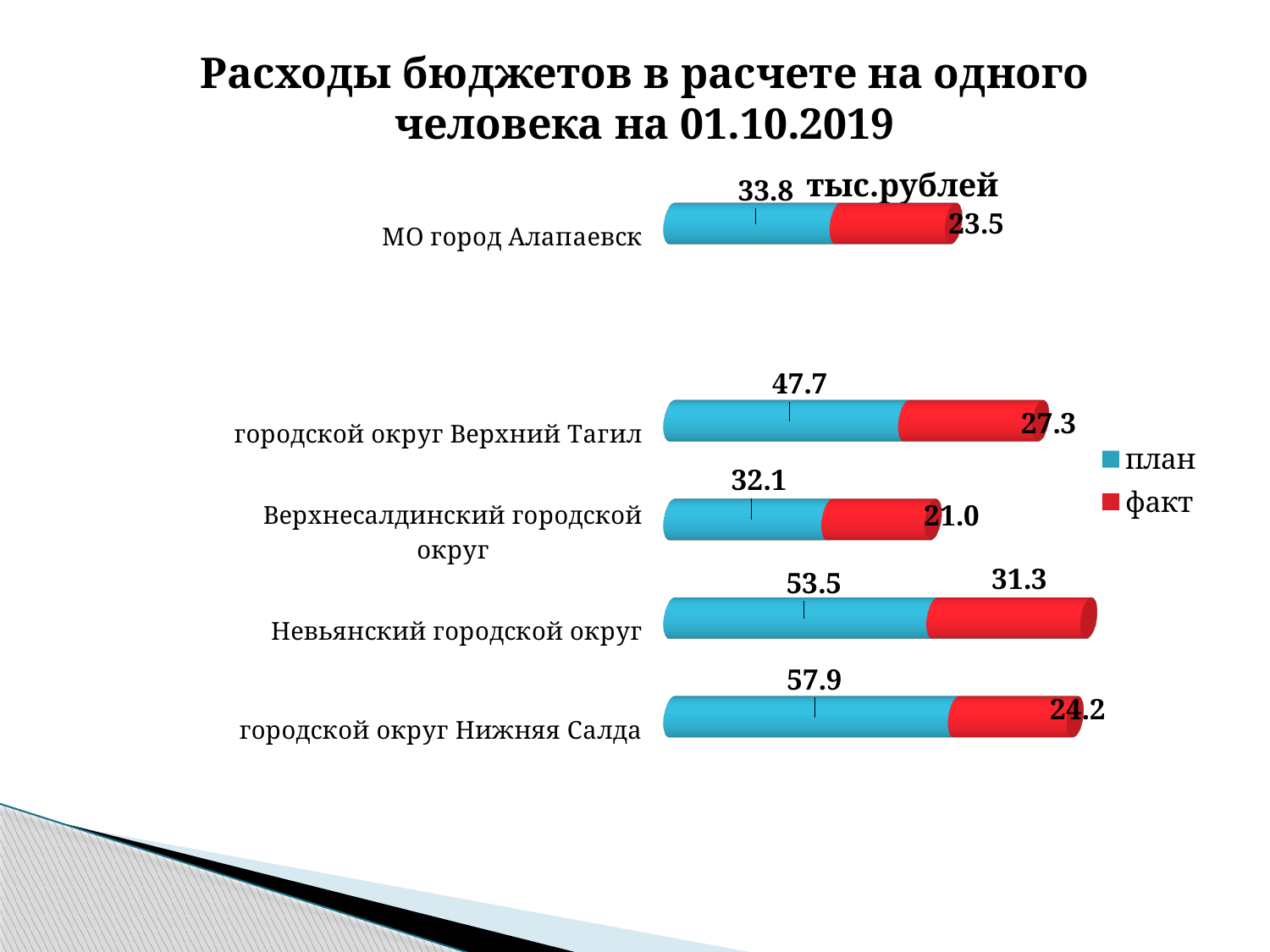
What is the план (plan) value for городской округ Нижняя Салда? 57.9 How many municipalities are shown in the chart? 5 What is the факт value for МО город Алапаевск? 23.5 What is the difference between the план and факт values for городской округ Верхний Тагил? 20.4 What is the факт (actual) value for Невьянский городской округ? 31.3 Which municipality has the highest факт value? Невьянский городской округ Which is larger: the план value for Невьянский городской округ or the план value for городской округ Верхний Тагил? Невьянский городской округ What is the total of the план and факт values for Невьянский городской округ? 84.8 Which municipality has the lowest факт value? Верхнесалдинский городской округ Which municipality has the highest план value? городской округ Нижняя Салда What type of chart is shown on the slide? Stacked bar chart How many series does the legend list? 2